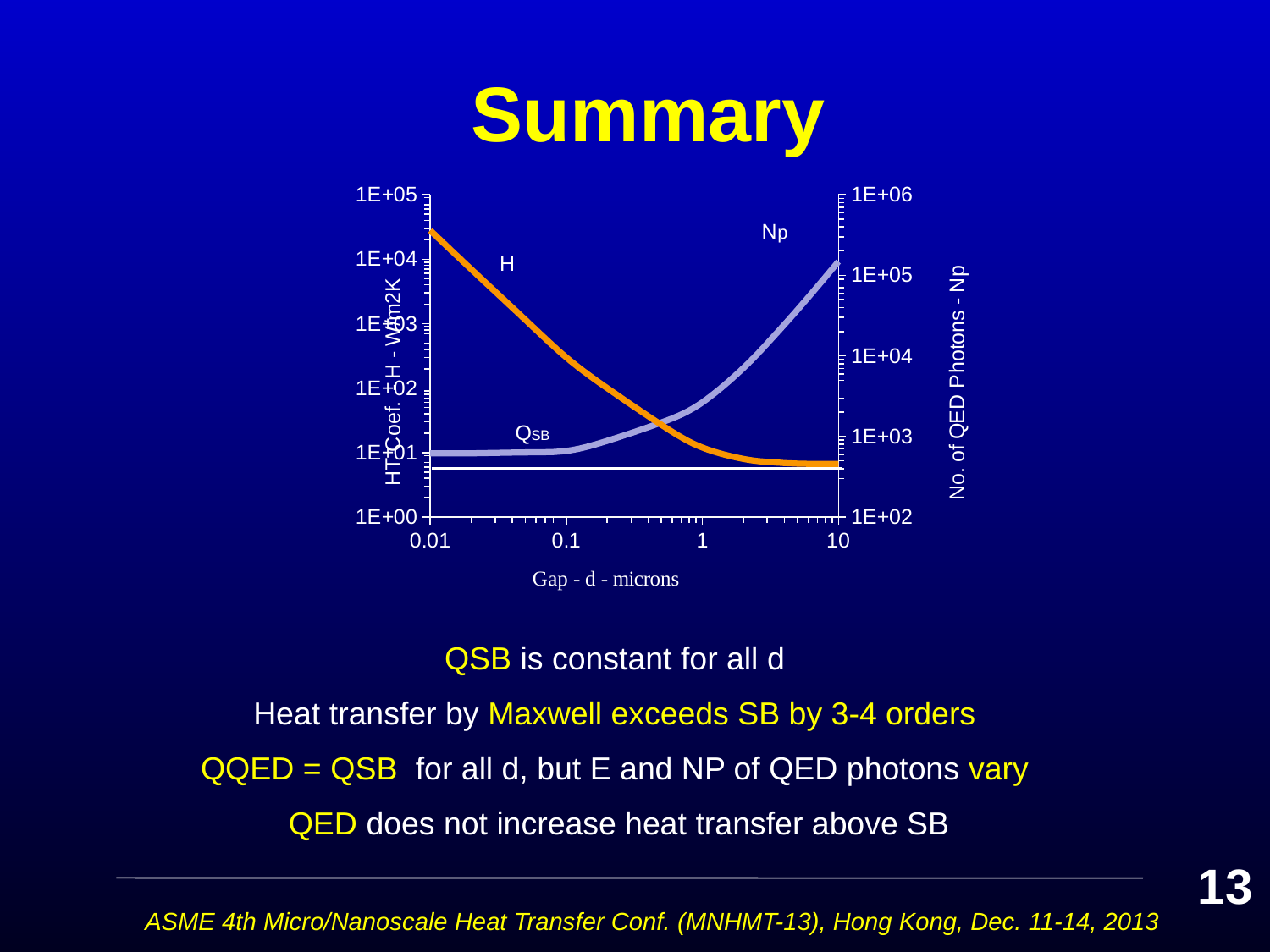
Is the value of H at a gap of 0.01 microns greater or less than 1E+04 on the left axis? greater At a gap of 0.01 microns, which is larger, H or QSB? H How many curves are plotted on the chart? 3 Is the value of Np at a gap of 0.1 microns greater or less than 1E+04 on the right axis? less Which curve on the chart is drawn as a flat horizontal line? QSB What kind of chart is shown on the slide? line chart Does the Np curve rise or fall as the gap d increases? rise What is the label of the right-hand y axis of the chart? No. of QED Photons - Np Is the value of H at a gap of 10 microns greater or less than 1E+02 on the left axis? less What is the label of the x axis of the chart? Gap - d - microns Does the H curve rise or fall as the gap d increases? fall